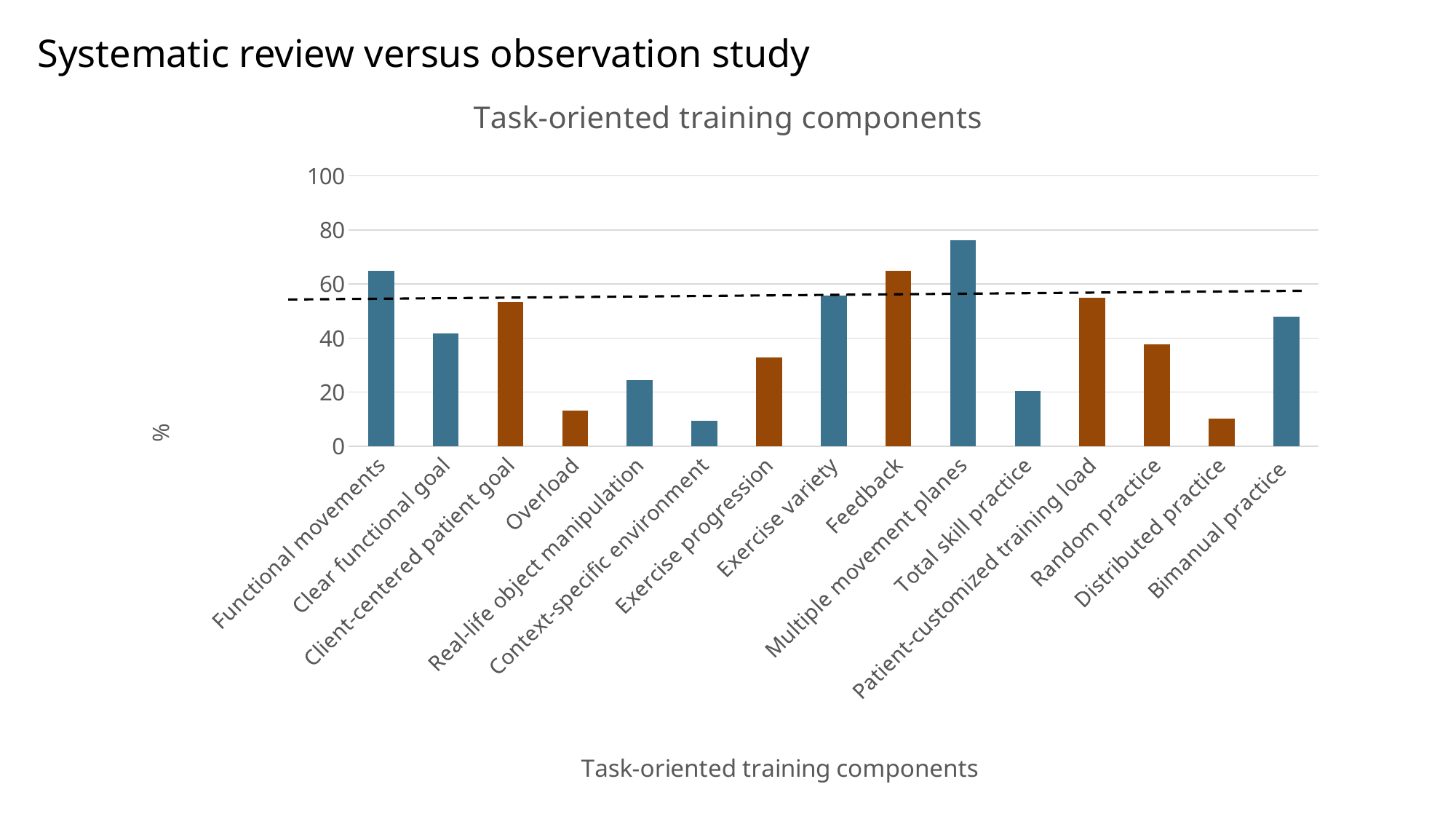
Is the value for Overload greater or less than 20? less Is the value for Exercise progression greater or less than 40? less What is the title of the chart? Task-oriented training components What kind of chart is shown on the slide? bar chart Is the value for Bimanual practice greater or less than 40? greater Which component has the highest bar? Multiple movement planes Which is larger, the value for Feedback or the value for Clear functional goal? Feedback Which is larger, the value for Overload or the value for Exercise progression? Exercise progression How many task-oriented training components are plotted on the x axis? 15 What is the label on the y axis of the chart? %